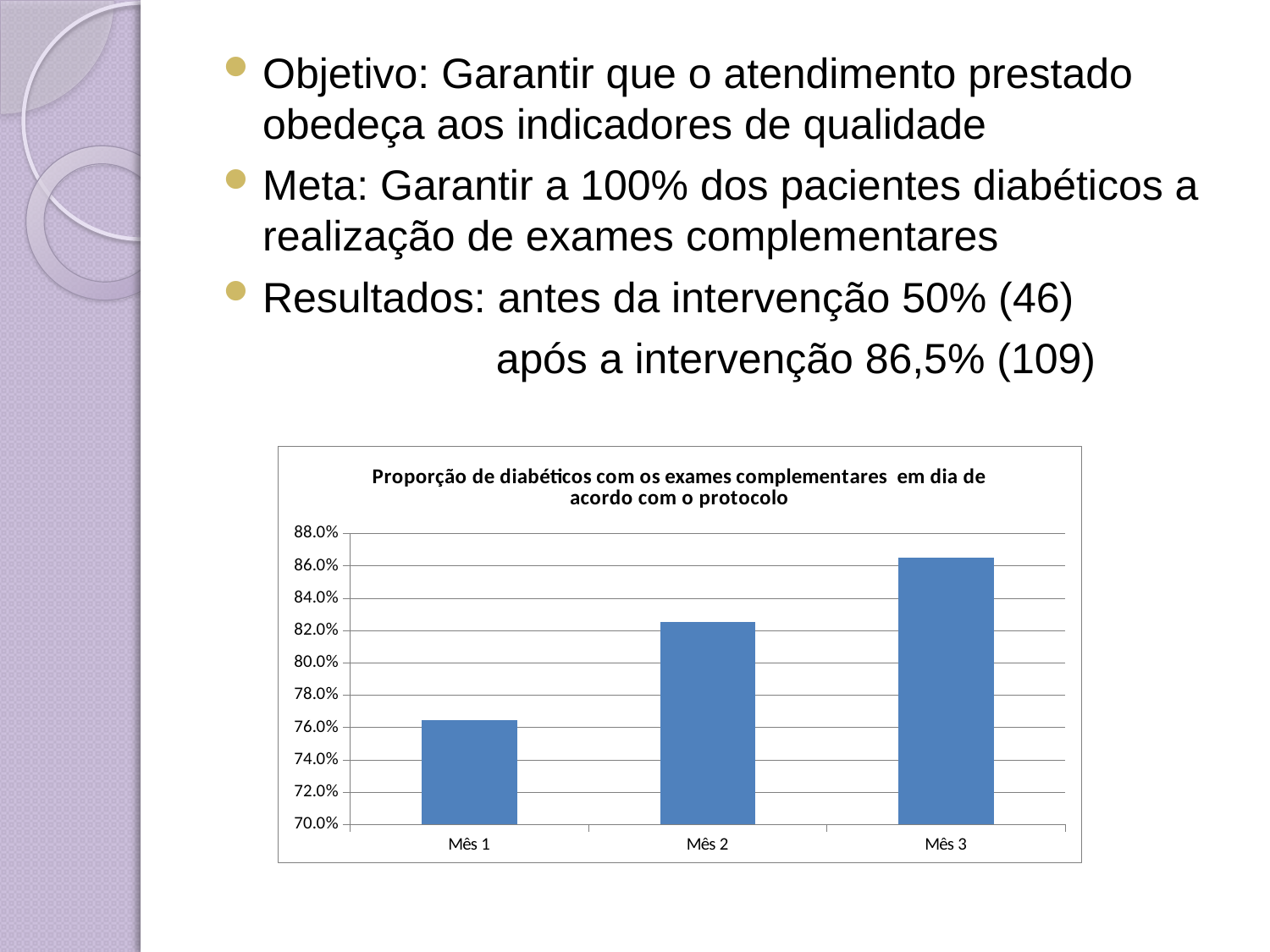
What kind of chart is shown on the slide? bar chart Do the values rise or fall from Mês 1 to Mês 3? rise Is the value for Mês 1 greater or less than 78.0%? less Is the value for Mês 3 greater or less than 84.0%? greater How many categories (months) are shown on the x axis of the chart? 3 Which month has the lowest proportion of diabetics with complementary exams up to date? Mês 1 Which is larger, the value for Mês 1 or the value for Mês 2? Mês 2 Which is larger, the value for Mês 2 or the value for Mês 3? Mês 3 Is the value for Mês 1 greater or less than 74.0%? greater What is the title of the chart? Proporção de diabéticos com os exames complementares em dia de acordo com o protocolo Which month has the highest proportion of diabetics with complementary exams up to date? Mês 3